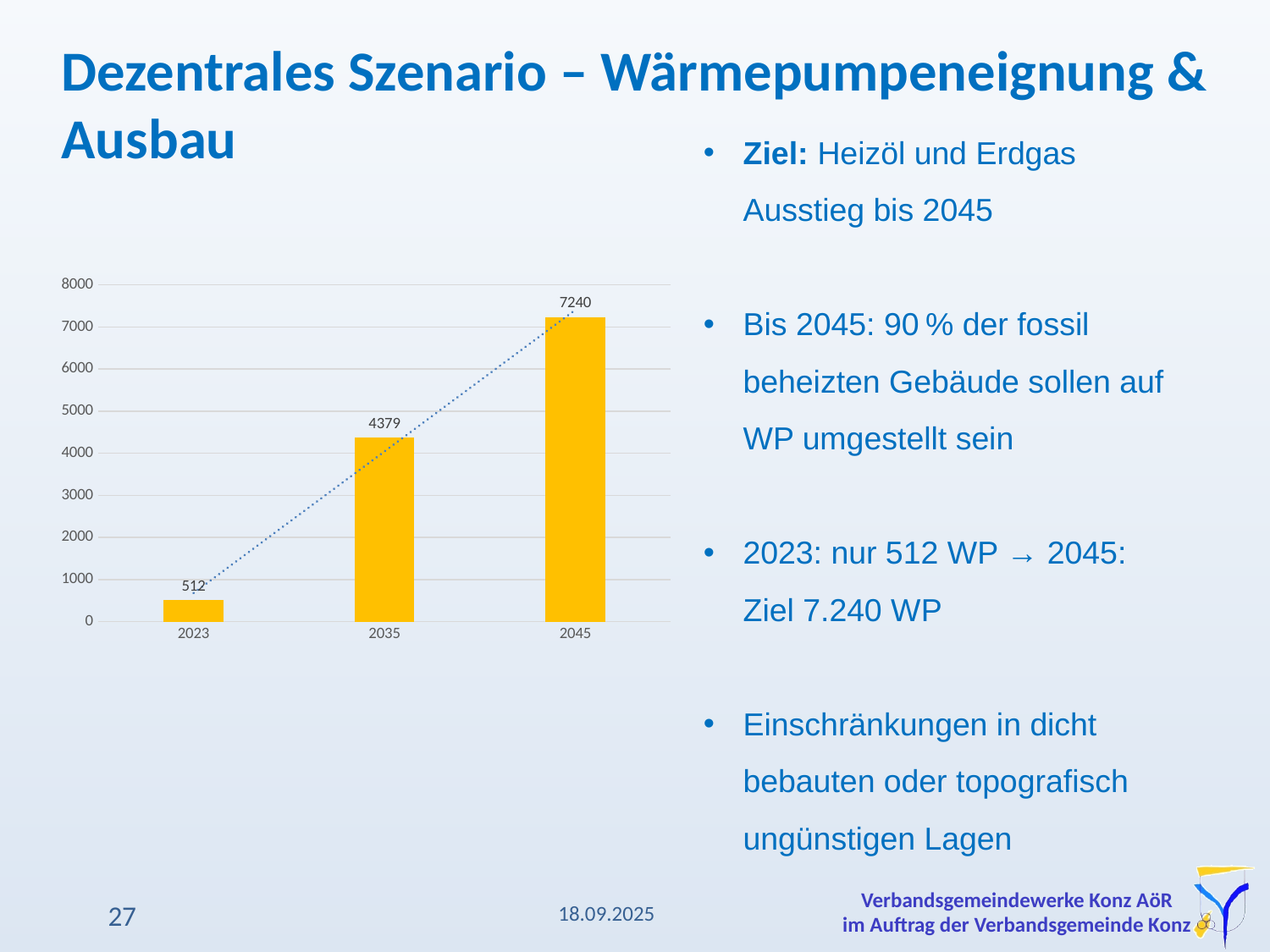
What is the value shown for 2045? 7240 What is the difference between the values for 2035 and 2023? 3867 What kind of chart is shown on the slide? bar chart What is the difference between the values for 2045 and 2035? 2861 Which year has the lowest value? 2023 Do the values rise or fall from 2023 to 2045? rise Which is larger, the value for 2035 or the value for 2023? 2035 What is the value shown for 2023? 512 Is the value for 2035 greater or less than 4000? greater Which year has the highest value? 2045 How many years are shown on the x axis? 3 What is the value shown for 2035? 4379